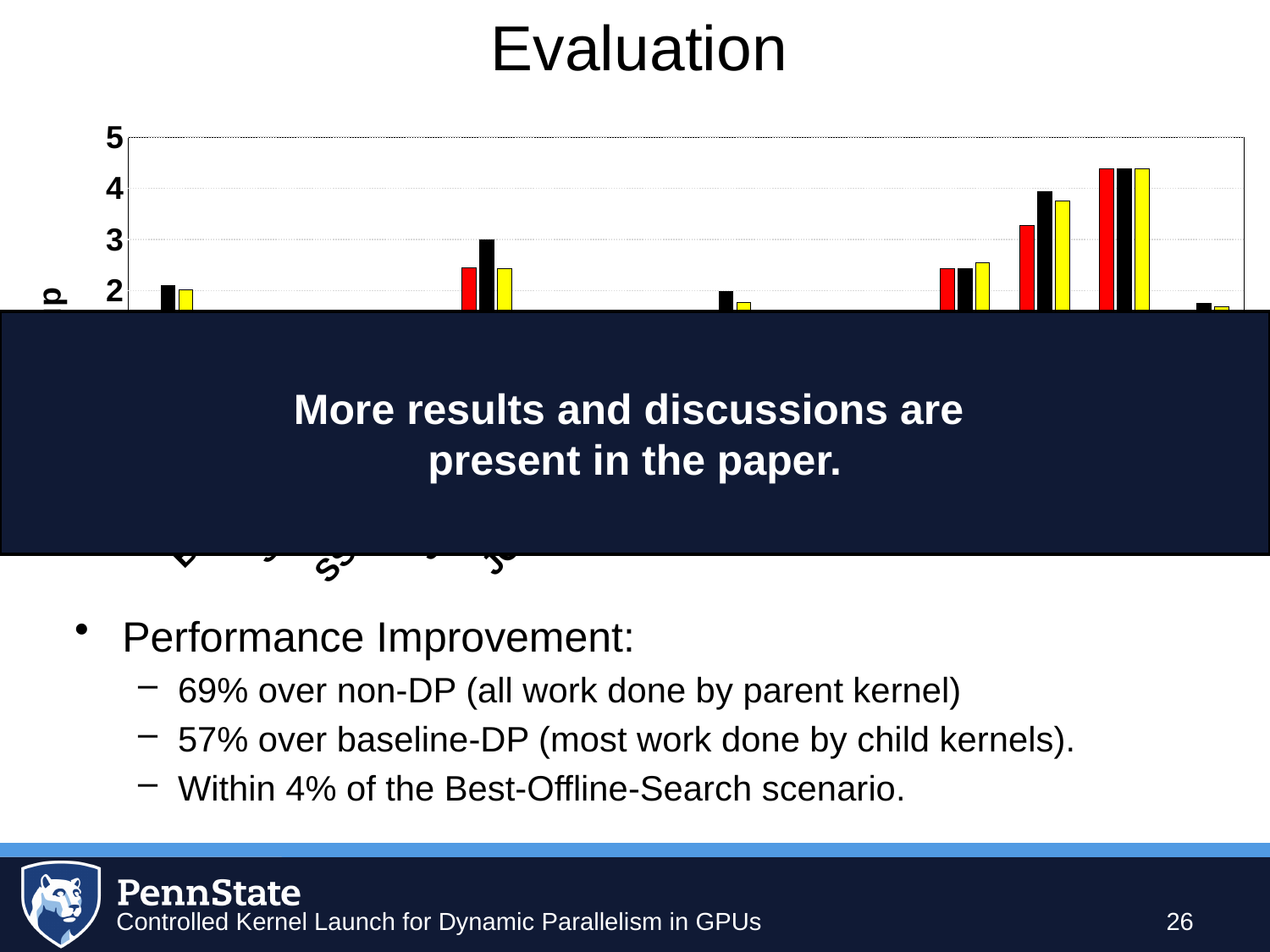
How many different bar colours are used in the chart? 3 What is the highest tick label shown on the y axis of the chart? 5 What kind of chart is shown on the slide? bar chart Is the value of the tallest bar in the chart greater or less than 4? greater Is the value of the tallest bar in the chart greater or less than 5? less